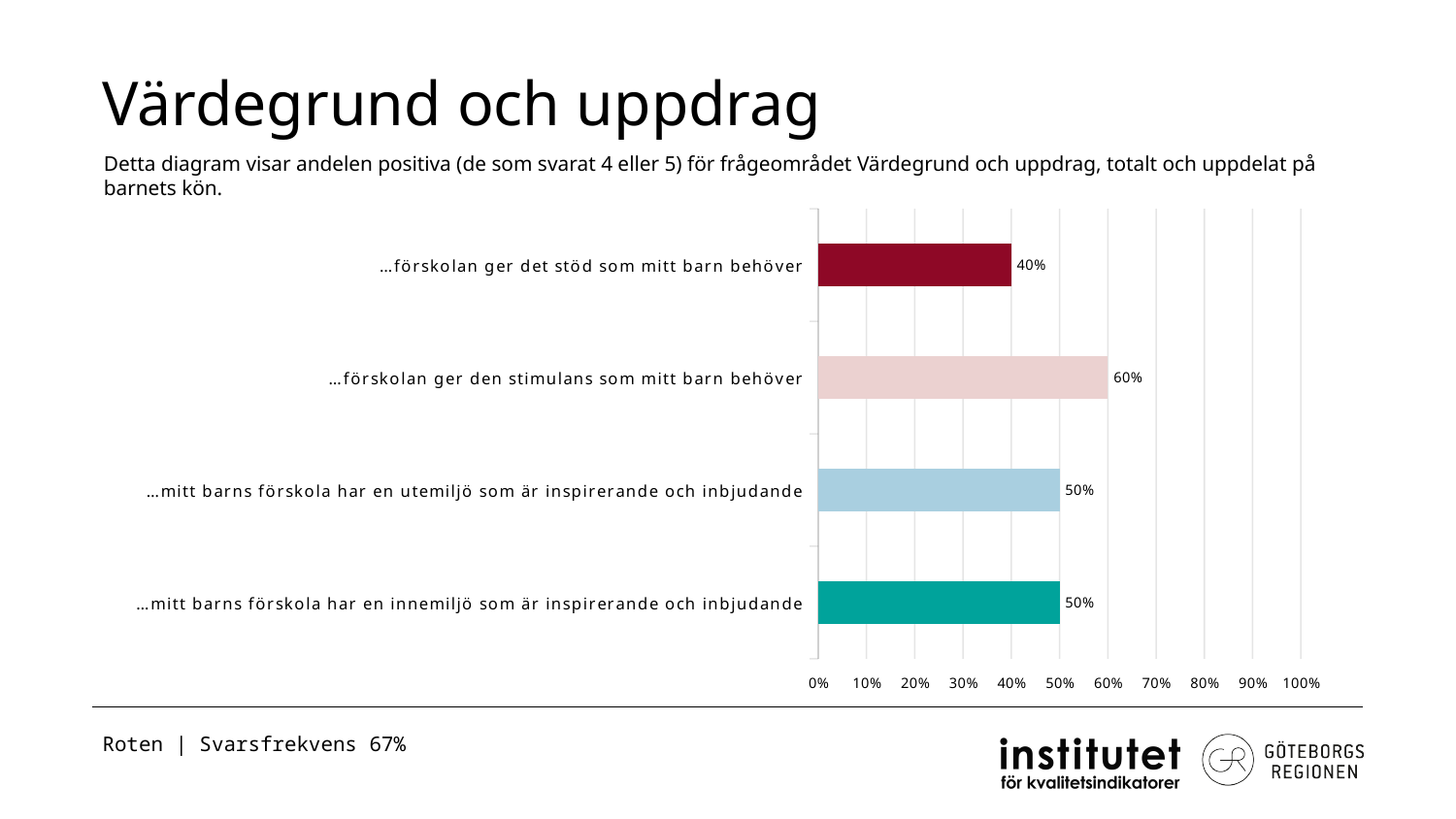
Is the value for "…förskolan ger det stöd som mitt barn behöver" greater or less than 50%? less Which is larger: the value for "…förskolan ger den stimulans som mitt barn behöver" or the value for "…mitt barns förskola har en utemiljö som är inspirerande och inbjudande"? …förskolan ger den stimulans som mitt barn behöver Which category has the highest value? …förskolan ger den stimulans som mitt barn behöver What is the highest value shown on the x axis of the chart? 100% What is the difference between the value for "…förskolan ger den stimulans som mitt barn behöver" and the value for "…förskolan ger det stöd som mitt barn behöver"? 20% What is the value for "…mitt barns förskola har en innemiljö som är inspirerande och inbjudande"? 50% What is the value for "…förskolan ger det stöd som mitt barn behöver"? 40% How many categories are shown in the chart? 4 What kind of chart is shown on the slide? bar chart What is the value for "…mitt barns förskola har en utemiljö som är inspirerande och inbjudande"? 50% Which category has the lowest value? …förskolan ger det stöd som mitt barn behöver What is the value for "…förskolan ger den stimulans som mitt barn behöver"? 60%